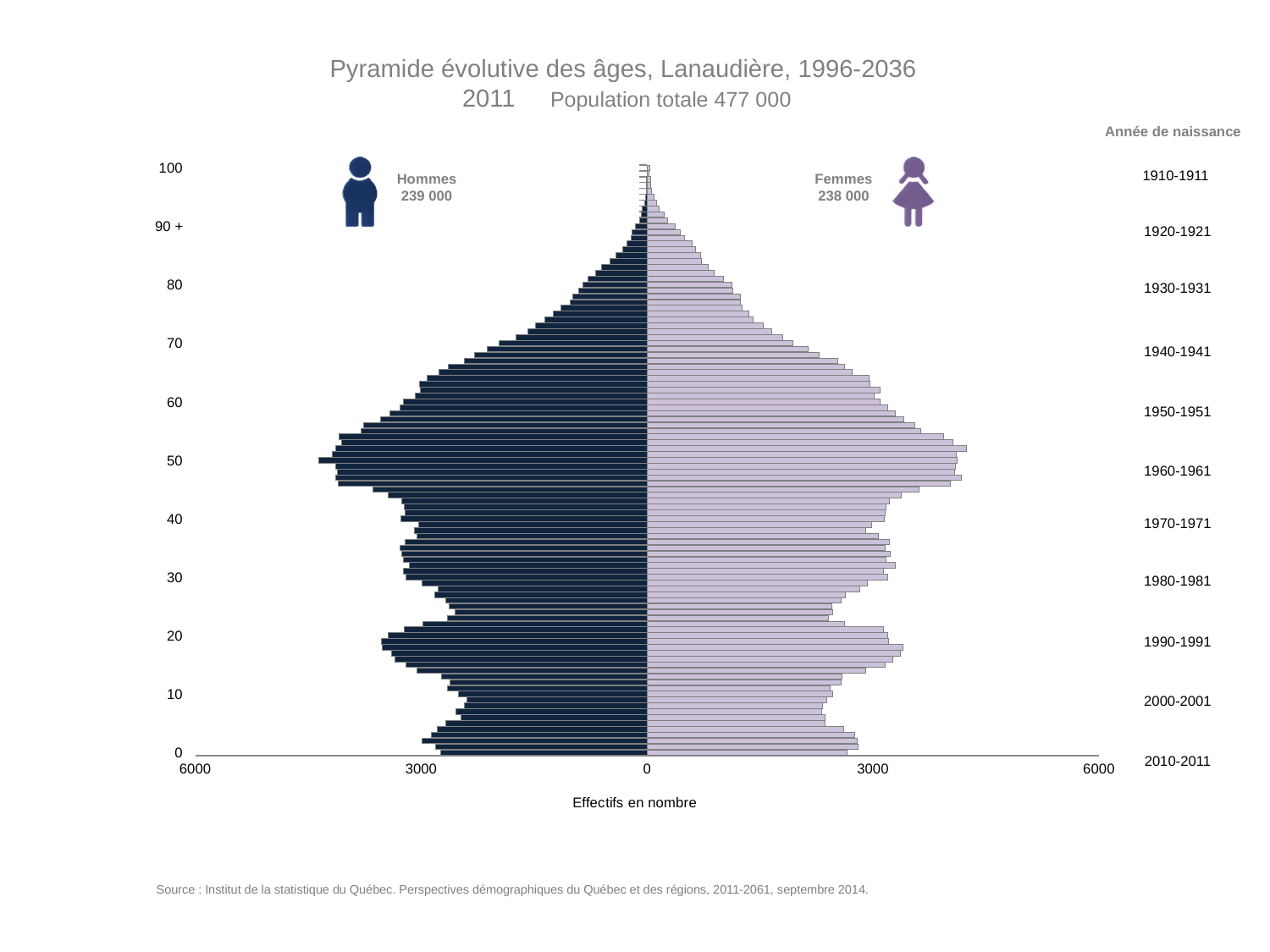
How many population groups (series) does the chart show? 2 Do the bar lengths rise or fall as age increases from 60 to 100? fall Which group is larger, Hommes or Femmes? Hommes Around which labelled age is the bar for Hommes the longest? 50 Is the value for Femmes at age 80 greater or less than 3000? less Is the value for Hommes at age 50 greater or less than 3000? greater What is the number of Femmes shown on the chart? 238 000 What is the number of Hommes shown on the chart? 239 000 What is the total population shown for 2011? 477 000 What kind of chart is shown on the slide? Bar chart (population pyramid) What is the difference between the number of Hommes and the number of Femmes? 1 000 What is the title of the horizontal axis? Effectifs en nombre